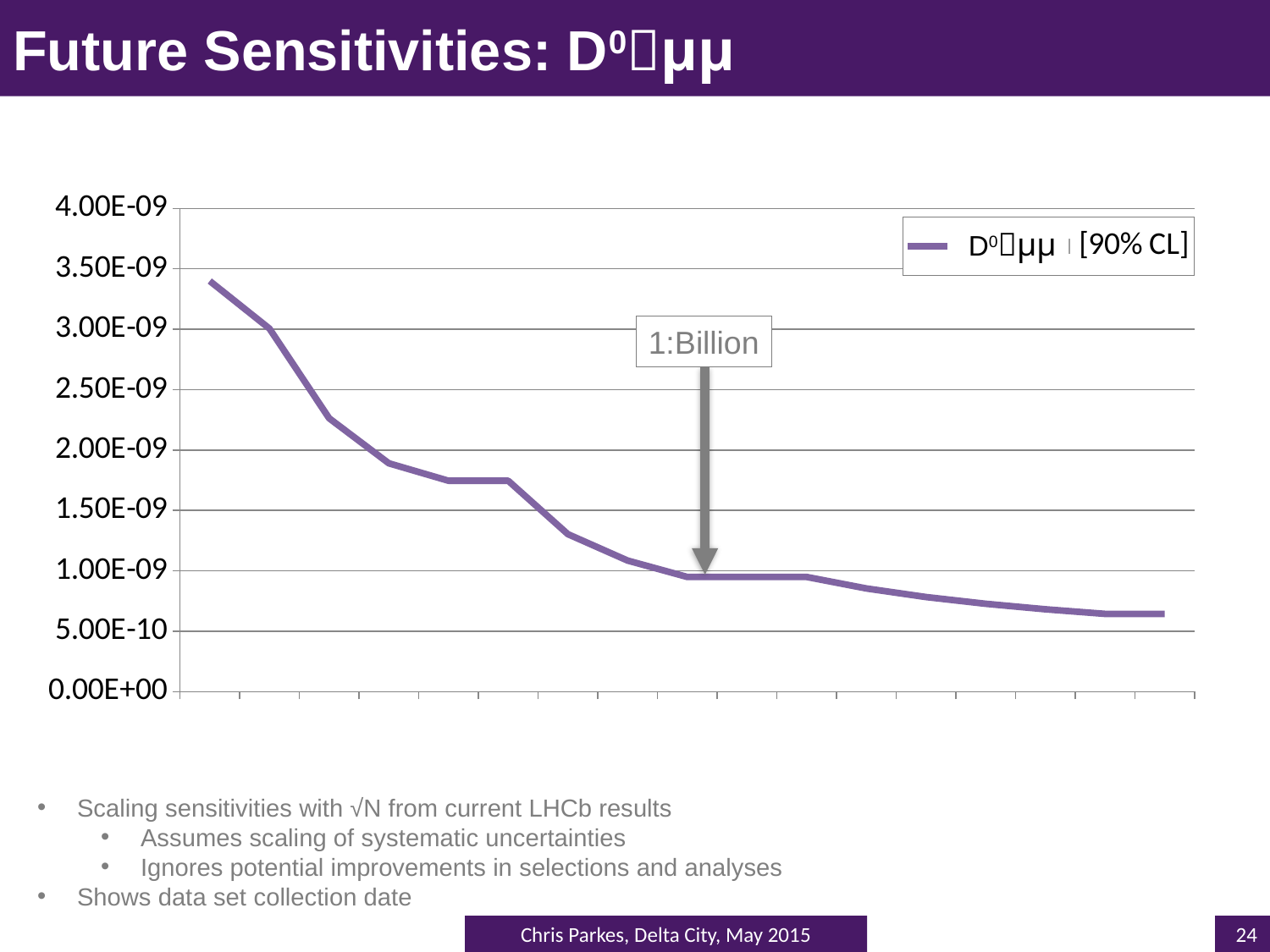
Is the value of the leftmost point on the line greater or less than 3.00E-09? greater What kind of chart is shown on the slide? line chart Is the value of the rightmost point on the line greater or less than 5.00E-10? greater How many series does the legend list? 1 What text label is shown in the legend of the chart? D0→μμ [90% CL] What annotation text is shown above the arrow pointing at the line? 1:Billion Which is larger, the value of the leftmost point or the value of the rightmost point on the line? the leftmost point Is the value at the point marked by the '1:Billion' arrow greater or less than 1.50E-09? less Do the values of the line rise or fall from left to right along the x axis? fall